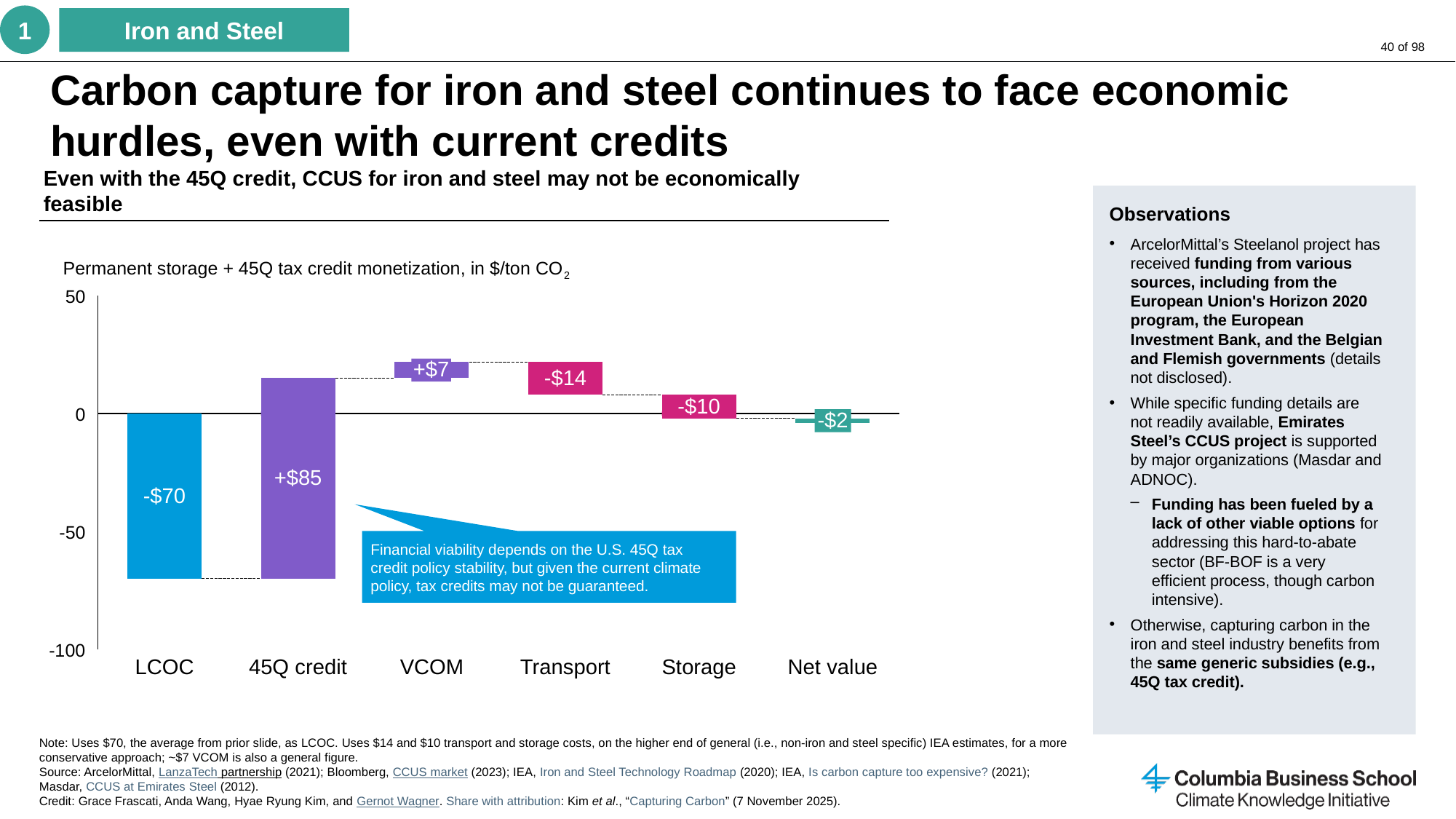
What is the value shown for VCOM? +$7 What is the value shown for the 45Q credit? +$85 Which category has the largest positive value? 45Q credit What is the value shown for Storage? -$10 What is the difference between the Transport cost and the Storage cost? $4 How many categories are shown on the x axis of the chart? 6 What is the Net value shown at the end of the chart? -$2 What is the value shown for LCOC? -$70 What is the value shown for Transport? -$14 Which category has the largest negative value? LCOC Which is larger in magnitude, the Transport cost or the Storage cost? Transport What unit is the chart measured in, according to its title? $/ton CO2